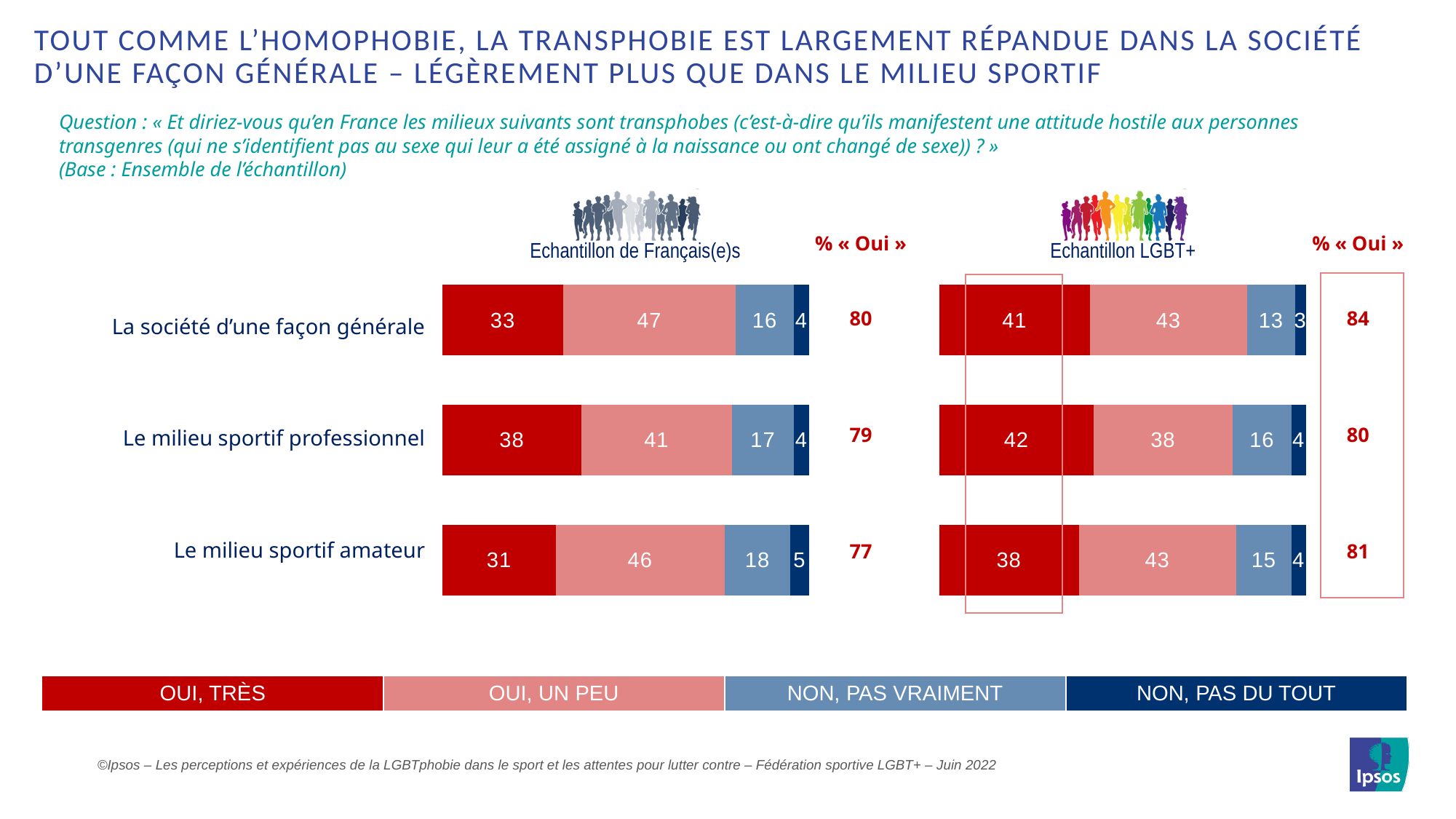
In the "Echantillon LGBT+" chart, which category has the highest "% « Oui »"? La société d'une façon générale In the "Echantillon LGBT+" chart, what is the difference between the "Oui, très" values for "Le milieu sportif professionnel" and "Le milieu sportif amateur"? 4 In the "Echantillon de Français(e)s" chart, which category has the lowest "Oui, très" value? Le milieu sportif amateur In the "Echantillon LGBT+" chart, what is the value for "Oui, un peu" for "La société d'une façon générale"? 43 How many series does the legend list? 4 How many categories are shown in the "Echantillon LGBT+" chart? 3 What kind of chart is used for the "Echantillon de Français(e)s" data? Stacked bar chart In the "Echantillon de Français(e)s" chart, what is the total of the "Non, pas vraiment" and "Non, pas du tout" values for "Le milieu sportif amateur"? 23 For "La société d'une façon générale", which chart shows the larger "Oui, très" value: "Echantillon de Français(e)s" or "Echantillon LGBT+"? Echantillon LGBT+ Which legend entry is shown in the darkest blue colour? Non, pas du tout In the "Echantillon de Français(e)s" chart, what is the "% « Oui »" for "Le milieu sportif amateur"? 77 In the "Echantillon de Français(e)s" chart, what is the value for "Oui, très" for "Le milieu sportif professionnel"? 38